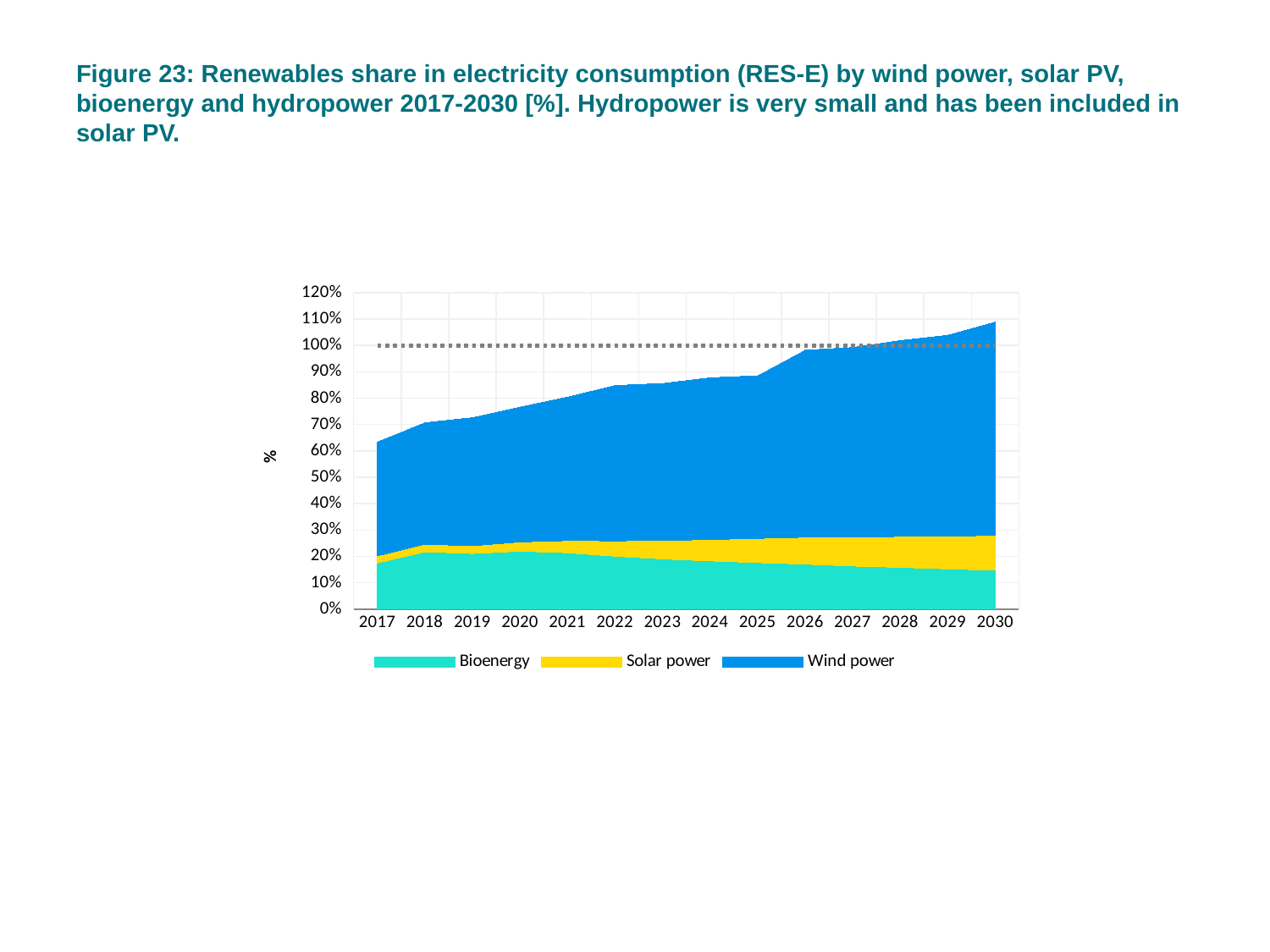
Does the Solar power share rise or fall between 2020 and 2030? Rise How many series does the legend list? 3 How many years are plotted along the x axis? 14 Which series has the smallest share in 2017? Solar power Is the total renewables share in 2022 greater or less than 90%? less Is the total renewables share in 2030 greater or less than 100%? greater What kind of chart is shown on the slide? Stacked area chart Is the total renewables share in 2017 greater or less than 70%? less Does the total renewables share rise or fall from 2017 to 2030? Rise At what level is the horizontal dotted reference line drawn? 100% Which series occupies the largest share of the stacked area across all years? Wind power